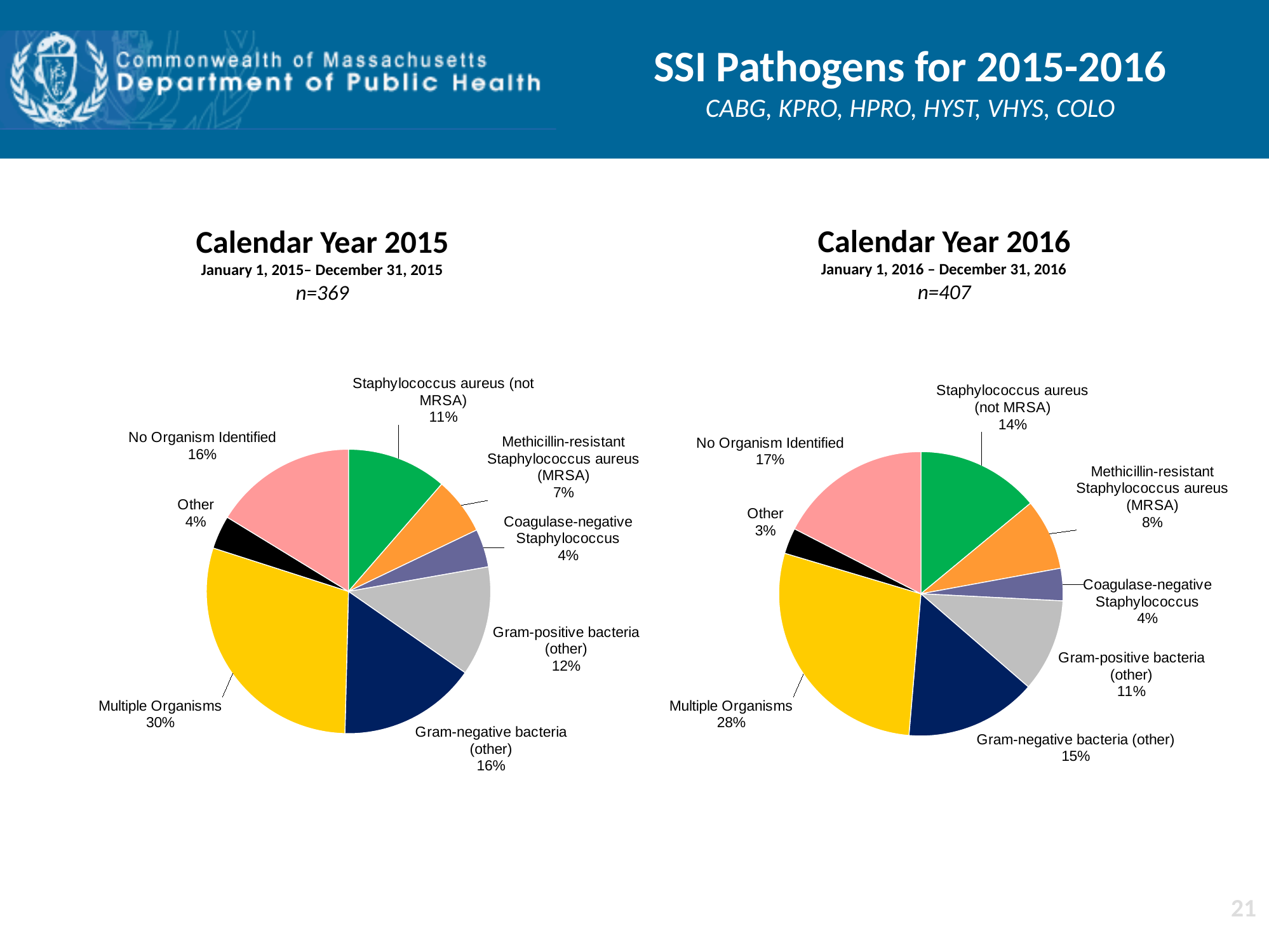
In the Calendar Year 2015 pie chart, what share is Multiple Organisms? 30% In the Calendar Year 2015 pie chart, which category has the largest slice? Multiple Organisms In the Calendar Year 2015 pie chart, what is the difference between the Gram-negative bacteria (other) share and the Gram-positive bacteria (other) share? 4% In the Calendar Year 2015 pie chart, what colour is the Multiple Organisms slice? Yellow What is the sample size (n) shown for the Calendar Year 2016 chart? n=407 What type of chart is used for Calendar Year 2016? Pie chart In the Calendar Year 2016 pie chart, which category has the smallest slice? Other In the Calendar Year 2016 pie chart, what share is No Organism Identified? 17% How many slices does the Calendar Year 2015 pie chart have? 8 In the Calendar Year 2016 pie chart, what share is Staphylococcus aureus (not MRSA)? 14% In the Calendar Year 2015 pie chart, what share is Methicillin-resistant Staphylococcus aureus (MRSA)? 7% In the Calendar Year 2016 pie chart, which is larger: Gram-negative bacteria (other) or Gram-positive bacteria (other)? Gram-negative bacteria (other)